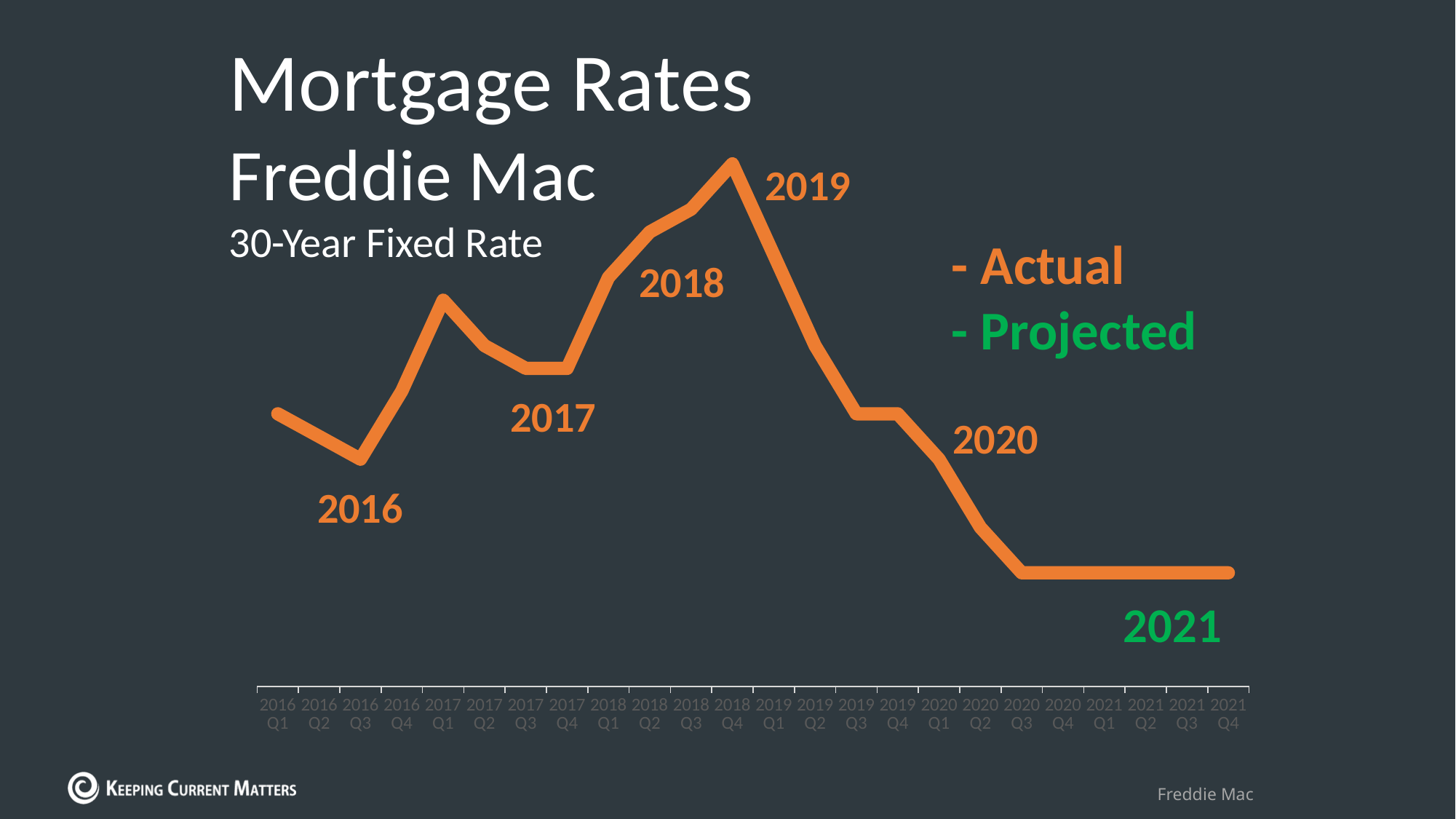
Which is higher, the rate in 2018 Q4 or the rate in 2016 Q3? 2018 Q4 Do mortgage rates rise or fall from 2018 Q4 to 2020 Q3? fall Which quarter has the lowest mortgage rate among the 2016 to 2019 quarters? 2016 Q3 What kind of chart is shown on the slide? line chart Do mortgage rates rise or fall from 2017 Q4 to 2018 Q4? rise How many quarterly points are shown along the x axis of the chart? 24 Which colour represents the Projected series in the legend? green How many series does the legend list? 2 What are the two legend entries on the chart? Actual and Projected Which quarter has the highest mortgage rate on the chart? 2018 Q4 Which is higher, the rate in 2017 Q1 or the rate in 2020 Q3? 2017 Q1 Do mortgage rates rise or fall from 2016 Q3 to 2017 Q1? rise